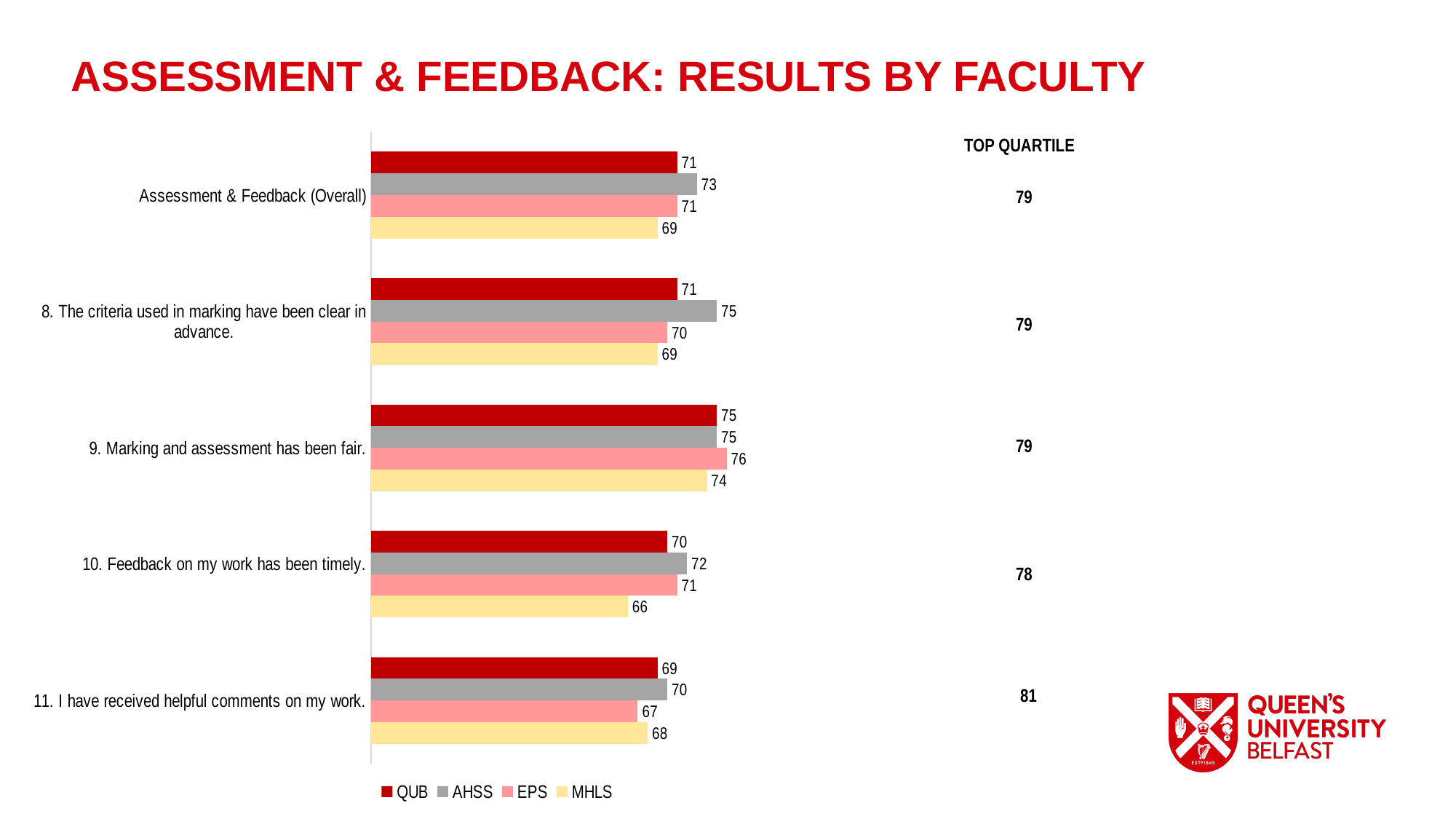
What is the TOP QUARTILE value shown for "11. I have received helpful comments on my work."? 81 What is the QUB value for "Assessment & Feedback (Overall)"? 71 What kind of chart is shown on the slide? Bar chart What is the AHSS value for "8. The criteria used in marking have been clear in advance."? 75 What is the difference between the AHSS and MHLS values for "8. The criteria used in marking have been clear in advance."? 6 Which faculty series has the highest value for "9. Marking and assessment has been fair."? EPS How many series does the legend list? 4 Which is larger for "11. I have received helpful comments on my work.": the QUB value or the EPS value? QUB How many categories are shown on the chart? 5 Which faculty series has the lowest value for "10. Feedback on my work has been timely."? MHLS What is the MHLS value for "10. Feedback on my work has been timely."? 66 What is the EPS value for "11. I have received helpful comments on my work."? 67